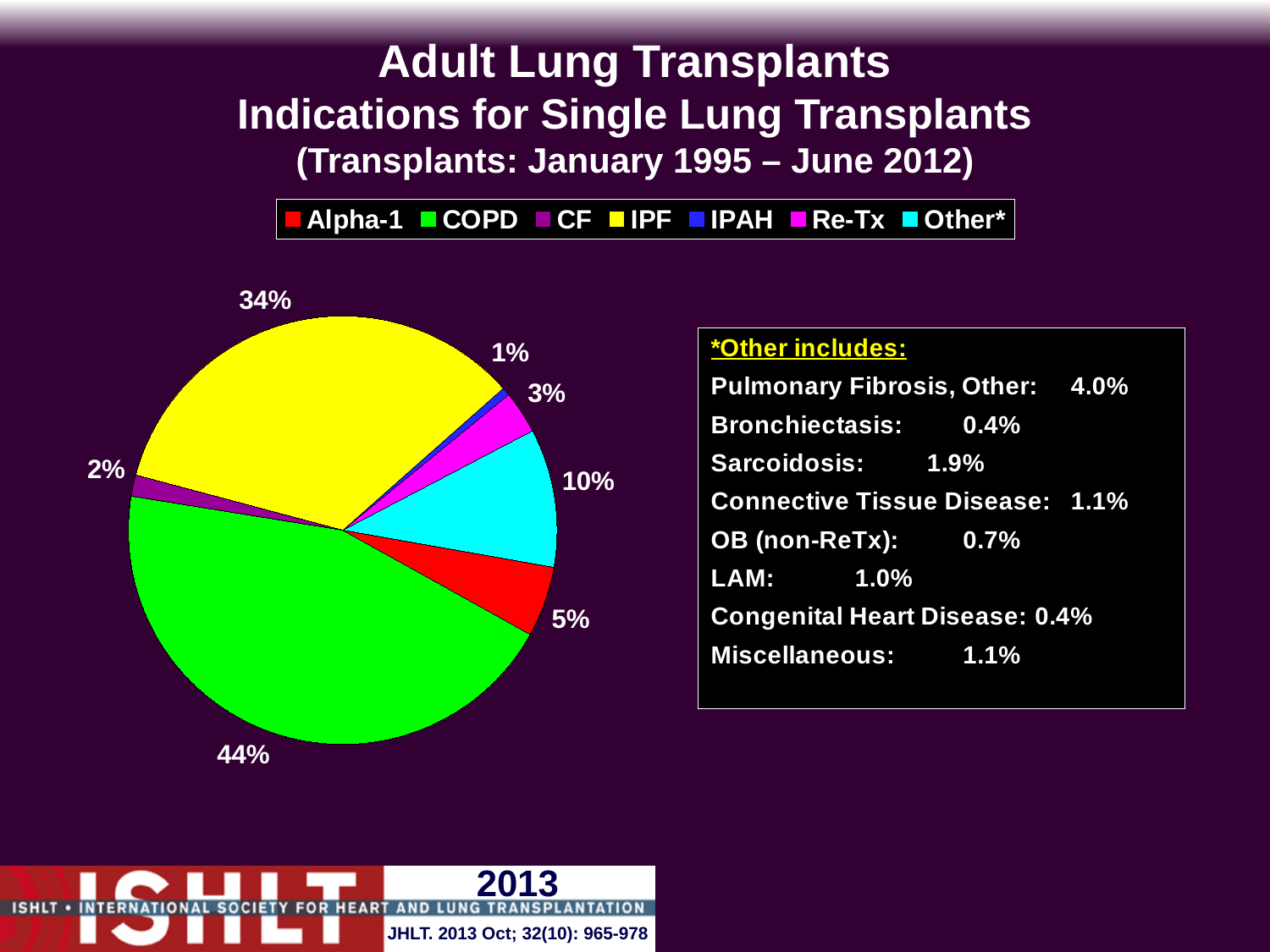
Which indication has the smallest slice of the pie? IPAH What share of single lung transplants is attributed to COPD? 44% What percentage of the pie is labelled for Alpha-1? 5% What is the difference in percentage points between the COPD slice and the IPF slice? 10 Which slice is larger, Alpha-1 or CF? Alpha-1 What percentage of the pie is labelled for Other*? 10% How many indications are listed in the legend? 7 What type of chart is shown on the slide? Pie chart What percentage of the pie is labelled for Re-Tx? 3% What colour is the COPD slice in the pie chart? Green Which indication has the largest slice of the pie? COPD What share of single lung transplants is attributed to IPF? 34%